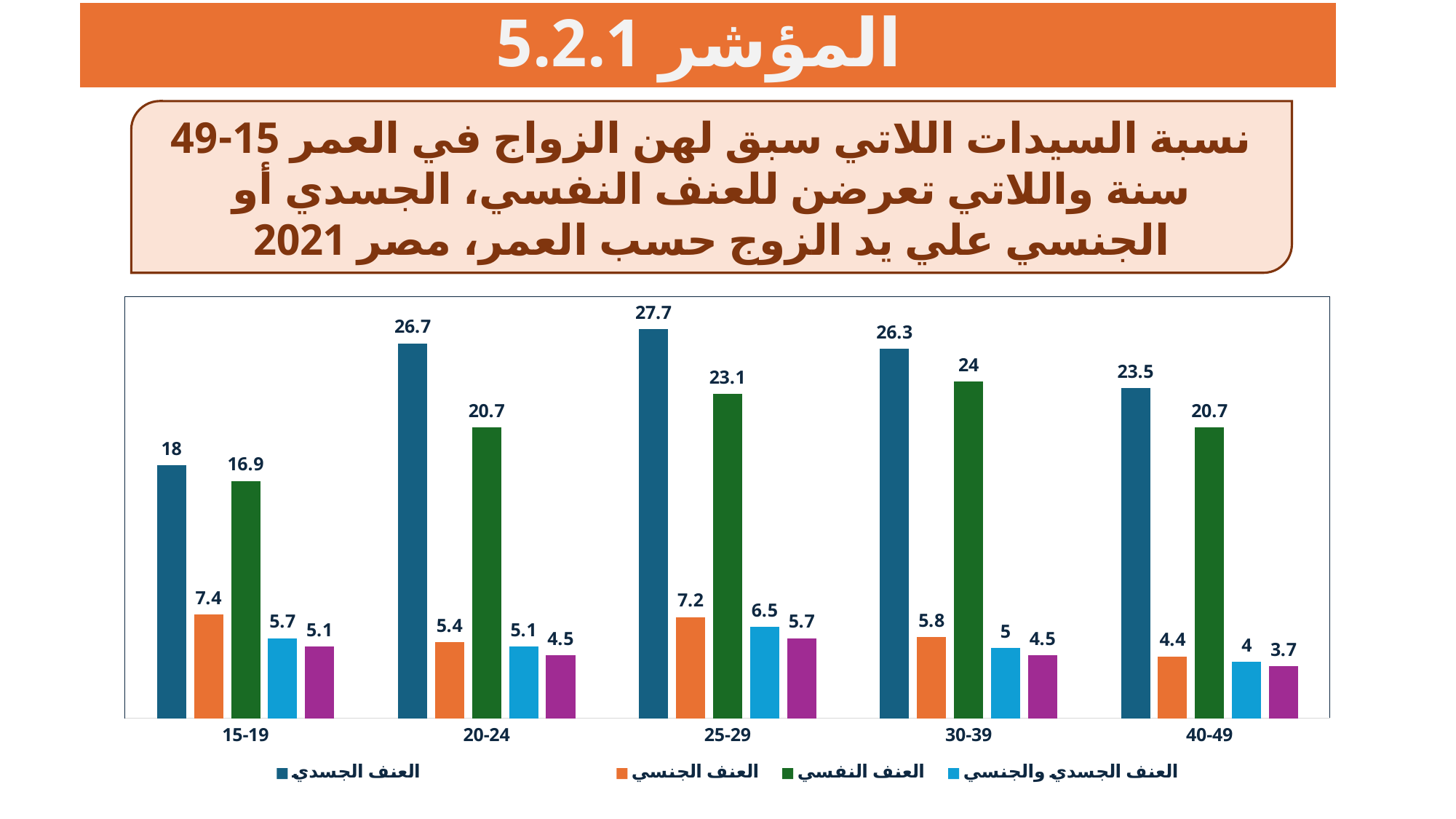
How many series does the legend list? 4 What is the difference between العنف الجسدي and العنف النفسي for the 20-24 age group? 6 How many age groups are shown on the x axis? 5 Which age group has the lowest value for العنف النفسي (psychological violence)? 15-19 Which colour represents العنف النفسي in the legend? Green Which is larger for the 15-19 age group: العنف الجسدي or العنف النفسي? العنف الجسدي What is the value of العنف الجسدي (physical violence) for the 25-29 age group? 27.7 Which age group has the highest value for العنف الجسدي (physical violence)? 25-29 What type of chart is shown on the slide? Bar chart What is the value of العنف الجنسي (sexual violence) for the 15-19 age group? 7.4 What is the value of العنف النفسي (psychological violence) for the 30-39 age group? 24 What is the value of العنف الجسدي والجنسي (physical and sexual violence) for the 40-49 age group? 4